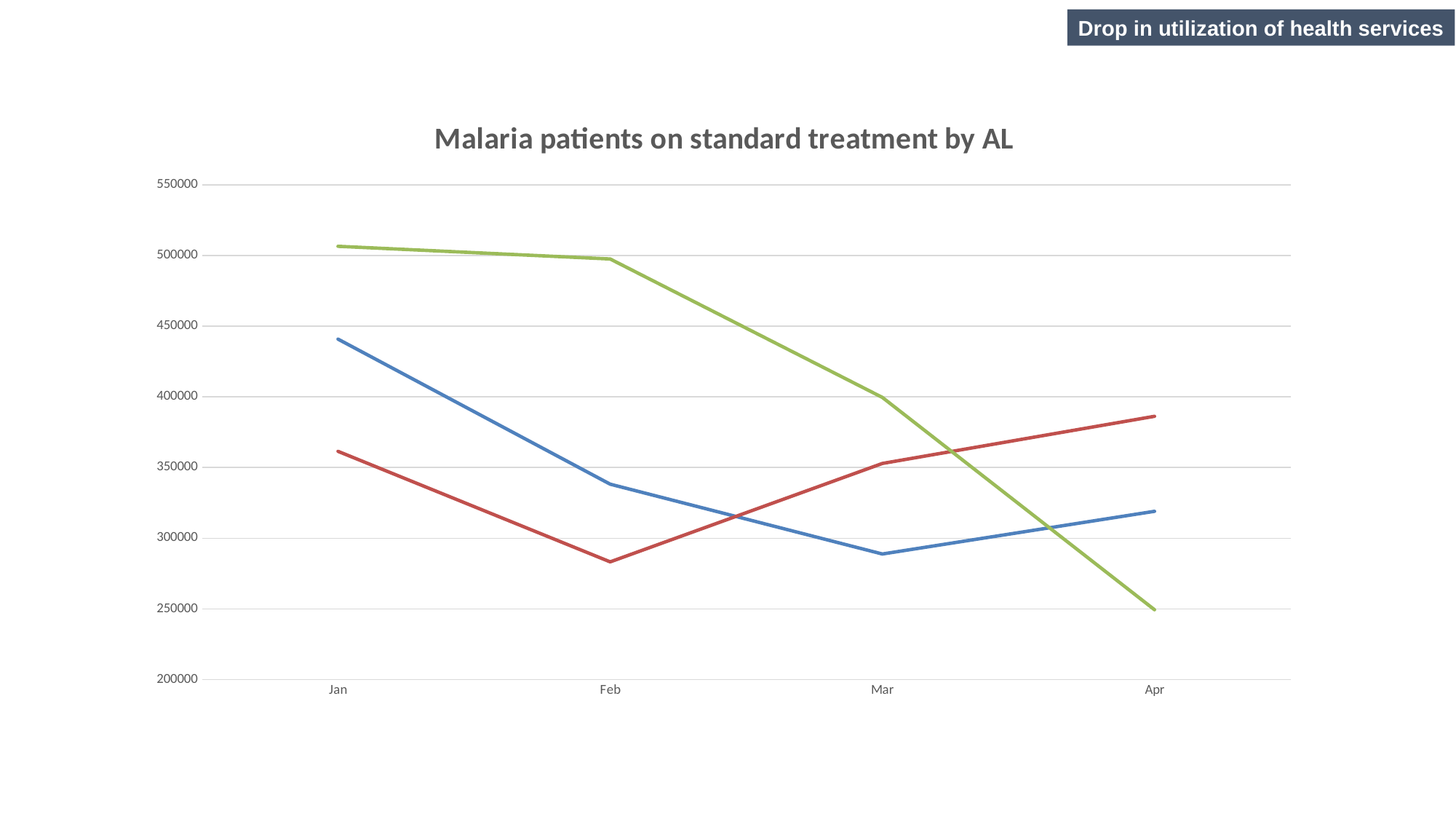
In Apr, which line has the higher value, the red line or the green line? red line How many lines are plotted on the chart? 3 How many months are shown on the x axis? 4 What kind of chart is shown on the slide? line chart What is the title of the chart? Malaria patients on standard treatment by AL In which month is the red line at its lowest? Feb Is the value of the green line in Apr greater or less than 300000? less In which month is the green line at its highest? Jan Is the value of the green line in Jan greater or less than 500000? greater Is the value of the red line in Feb greater or less than 300000? less Does the green line rise or fall from Jan to Apr? fall In which month is the green line at its lowest? Apr